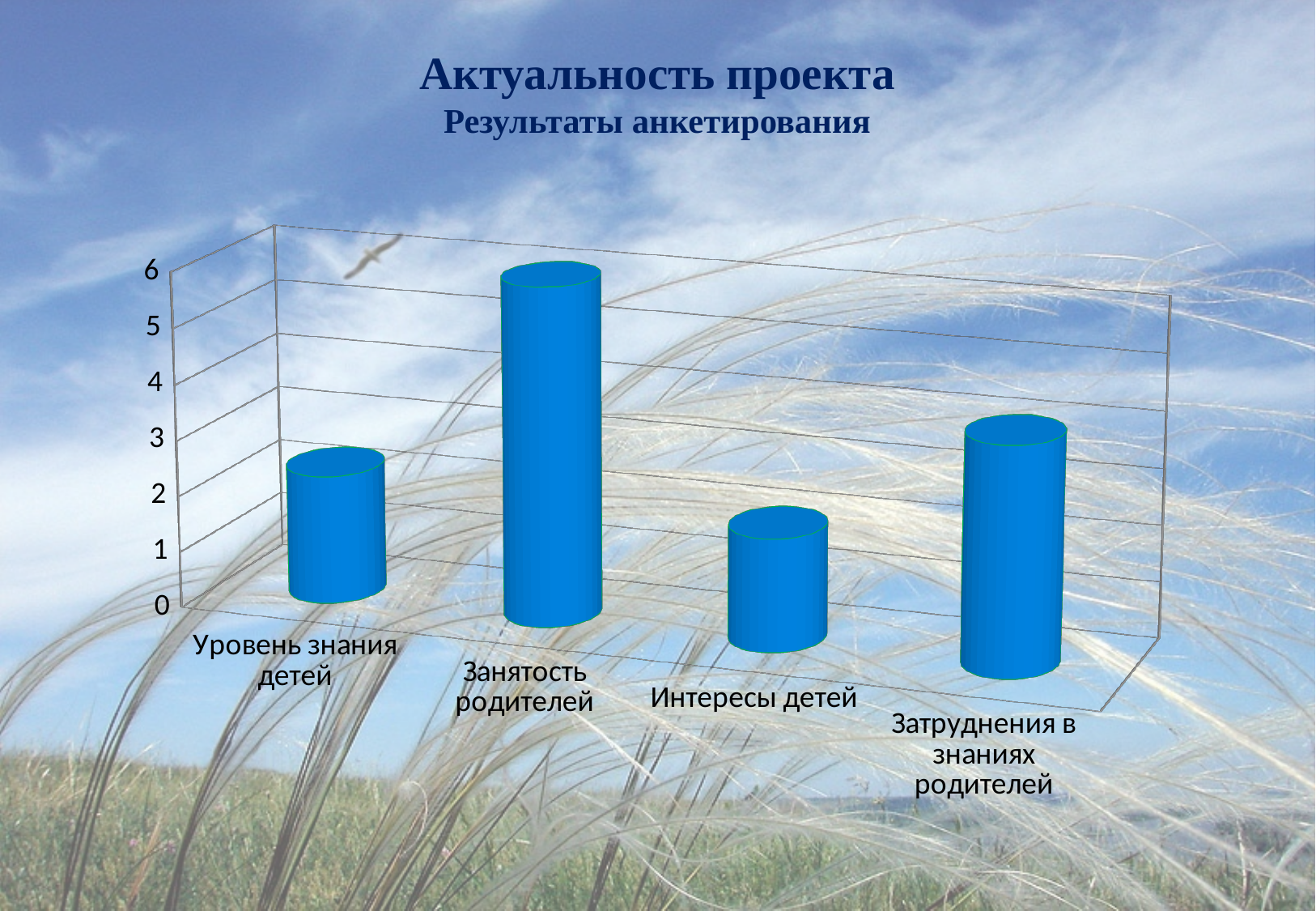
Is the value for Интересы детей greater or less than 4? less Which is larger: the value for Затруднения в знаниях родителей or the value for Уровень знания детей? Затруднения в знаниях родителей How many categories are shown on the chart? 4 Which category has the lowest value? Интересы детей What kind of chart is shown on the slide? bar chart Is the value for Затруднения в знаниях родителей greater or less than 2? greater What is the highest value shown on the vertical axis? 6 Is the value for Занятость родителей greater or less than 4? greater Which is larger: the value for Занятость родителей or the value for Интересы детей? Занятость родителей Which category has the highest value? Занятость родителей What is the subtitle shown above the chart? Результаты анкетирования